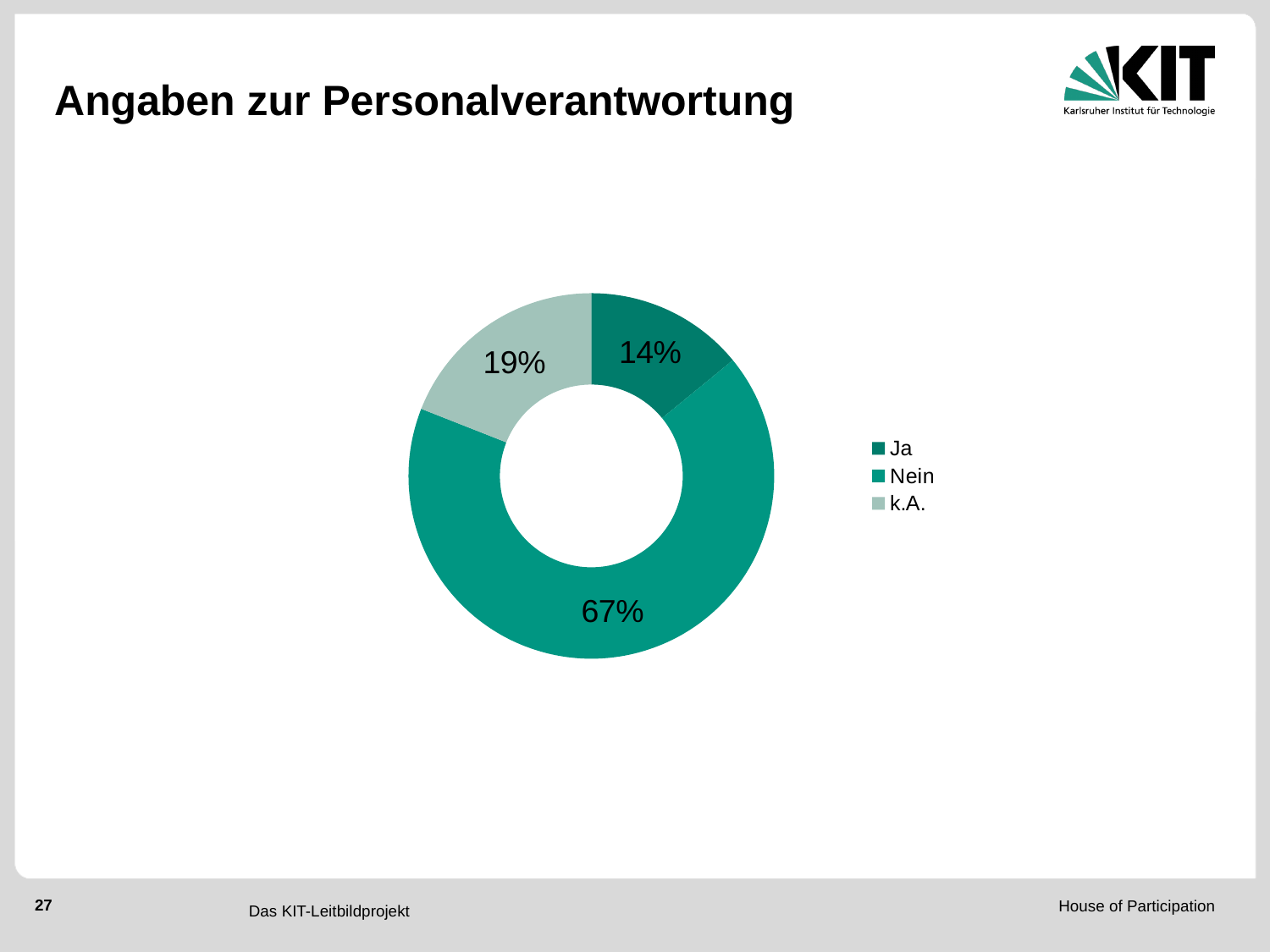
What is the difference in percentage points between the "k.A." and "Ja" slices? 5 Which slice is larger, "k.A." or "Ja"? k.A. Which category has the largest slice in the chart? Nein What kind of chart is shown on the slide? Doughnut chart What share of the doughnut chart does the "Nein" slice represent? 67% What share of the doughnut chart does the "k.A." slice represent? 19% What share of the doughnut chart does the "Ja" slice represent? 14% What is the difference in percentage points between the "Nein" and "Ja" slices? 53 Which entries are listed in the chart's legend? Ja, Nein, k.A. What is the title of the slide containing the chart? Angaben zur Personalverantwortung How many categories does the chart show? 3 Which category has the smallest slice in the chart? Ja